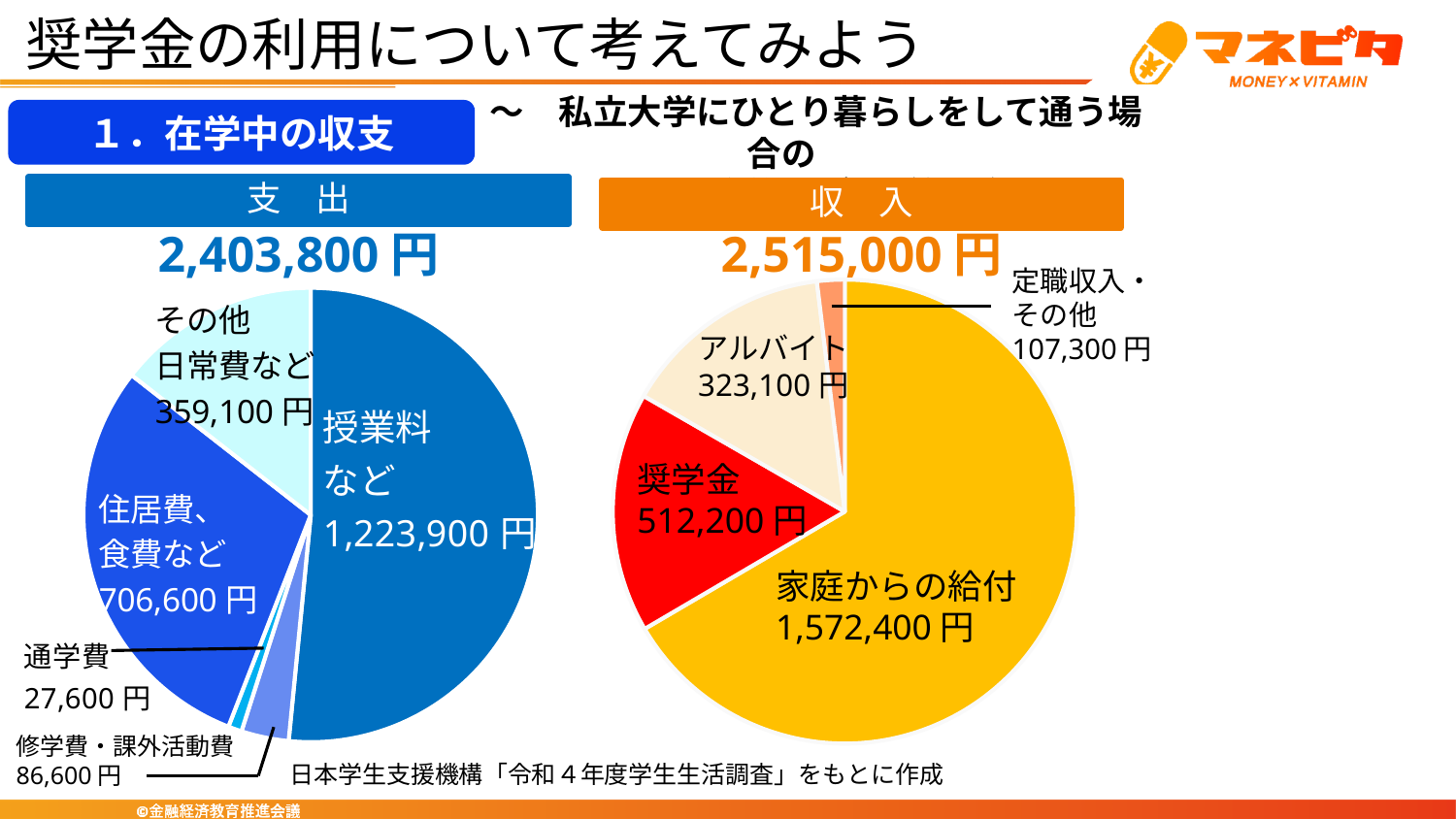
In the 収入 pie chart, what is the value for アルバイト? 323,100 円 In the 収入 pie chart, which category has the smallest value? 定職収入・その他 In the 支出 pie chart, which is larger: その他日常費など or 修学費・課外活動費? その他日常費など In the 支出 pie chart, which category has the smallest value? 通学費 How many categories does the 収入 pie chart have? 4 What type of charts are shown on the slide? Pie charts In the 収入 pie chart, what is the value for 奨学金? 512,200 円 In the 収入 pie chart, which category has the largest value? 家庭からの給付 In the 支出 pie chart, what is the value for 授業料など? 1,223,900 円 In the 支出 pie chart, what is the difference between 授業料など and 住居費、食費など? 517,300 円 In the 支出 pie chart, what is the value for 住居費、食費など? 706,600 円 In the 収入 pie chart, what is the difference between 家庭からの給付 and 奨学金? 1,060,200 円